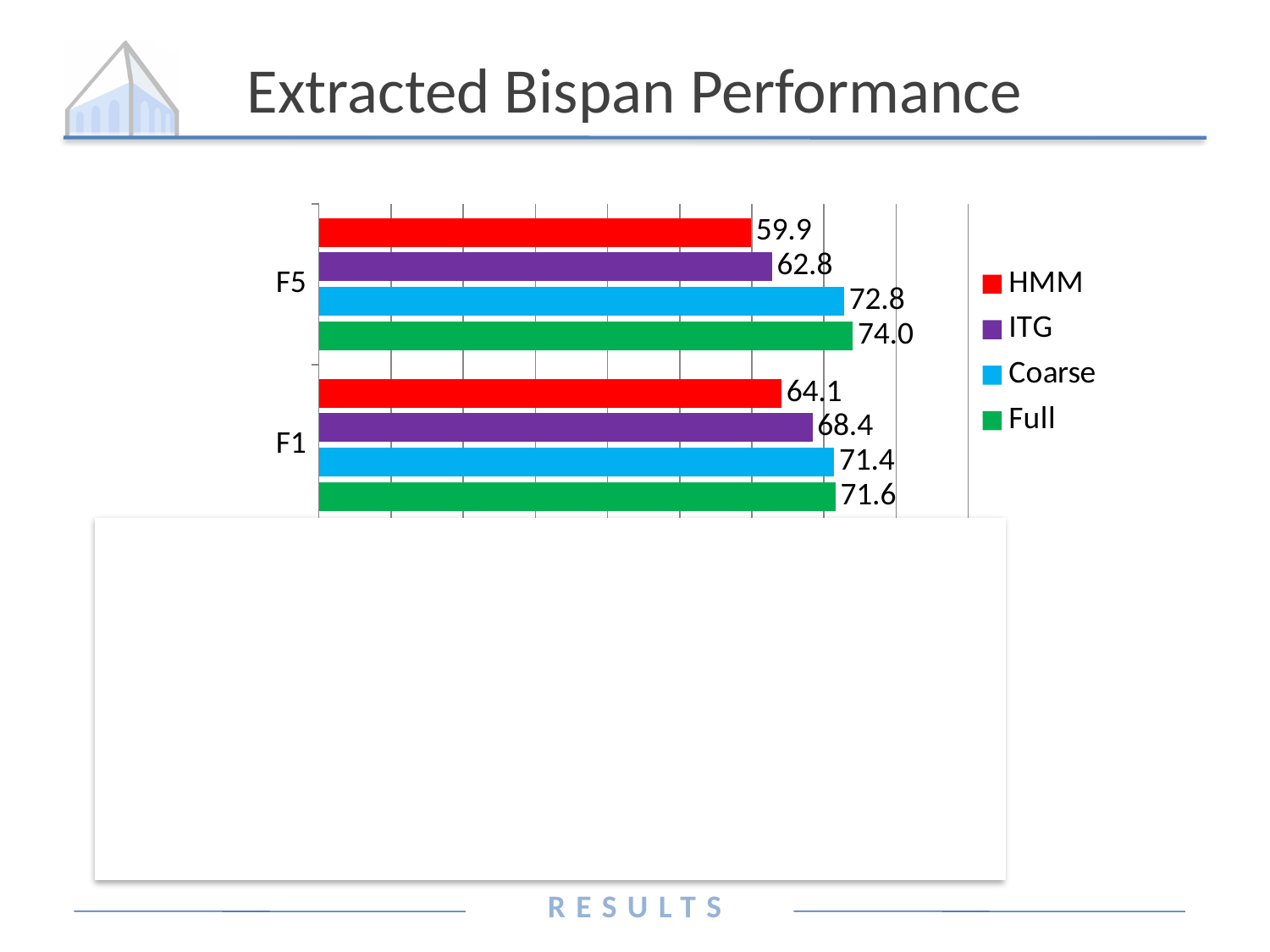
What is the title of the chart on the slide? Extracted Bispan Performance What is the difference between the Coarse and ITG values in the F1 category? 3.0 What is the difference between the Full and HMM values in the F5 category? 14.1 What is the value for HMM in the F5 category? 59.9 What is the value for ITG in the F1 category? 68.4 What kind of chart is shown on the slide? Bar chart Which is larger, the HMM value for F5 or the HMM value for F1? F1 What is the value for Full in the F1 category? 71.6 How many series does the legend list? 4 What is the value for Coarse in the F5 category? 72.8 Which series has the highest value in the F5 category? Full Which series has the lowest value in the F1 category? HMM